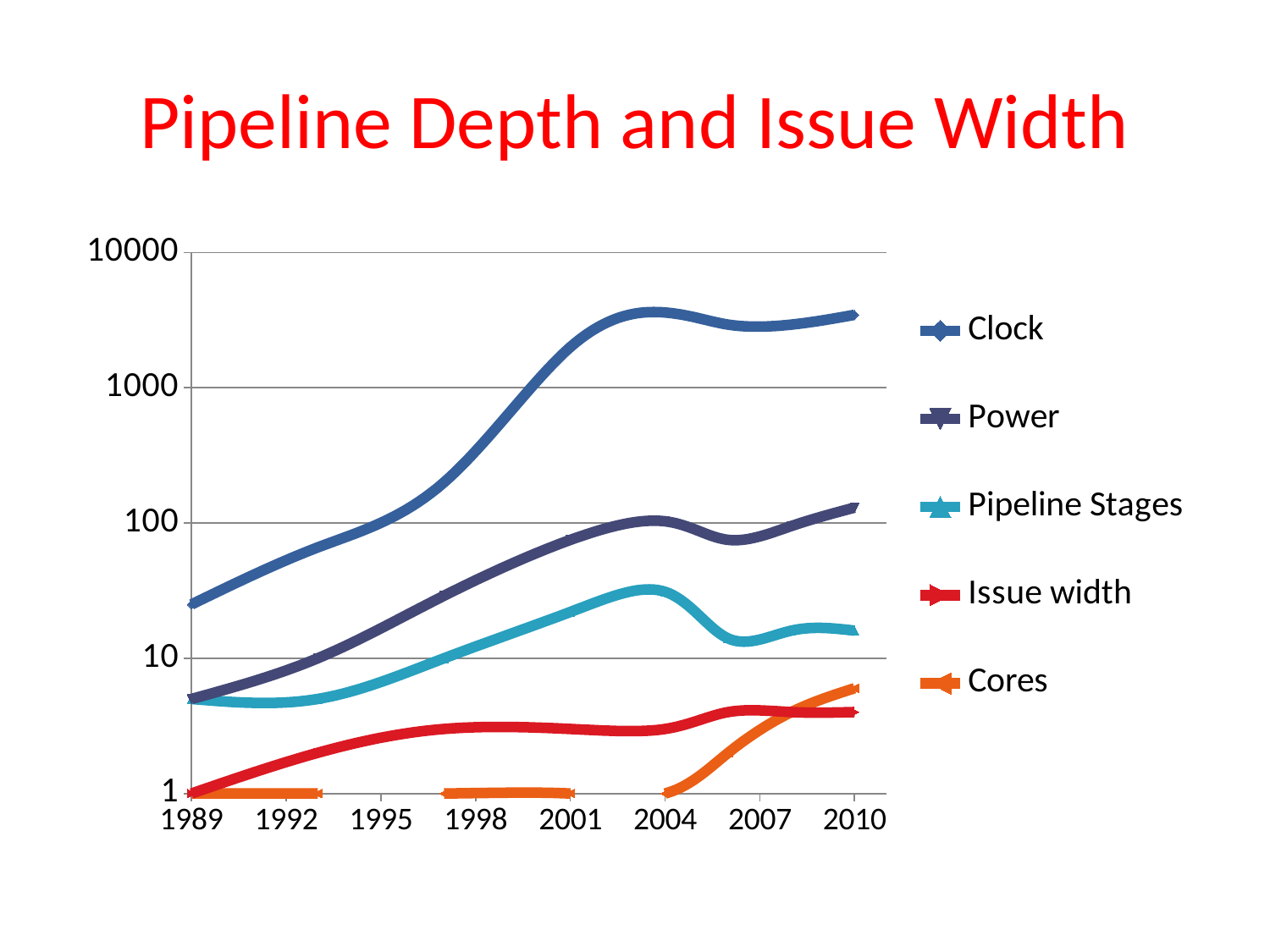
Does the Clock series rise or fall from 1989 to 2004? rise Is the value for Issue width in 2007 greater or less than 10? less What is the value for Cores in 1989? 1 Is the value for Power in 1989 greater or less than 10? less Which series has the lowest value in 2001? Cores Is the value for Pipeline Stages in 2004 greater or less than 10? greater Which series has the highest value in 2010? Clock How many series does the legend list? 5 In 2010, which is larger: Cores or Issue width? Cores What kind of chart is shown on the slide? line chart What is the title of the slide? Pipeline Depth and Issue Width